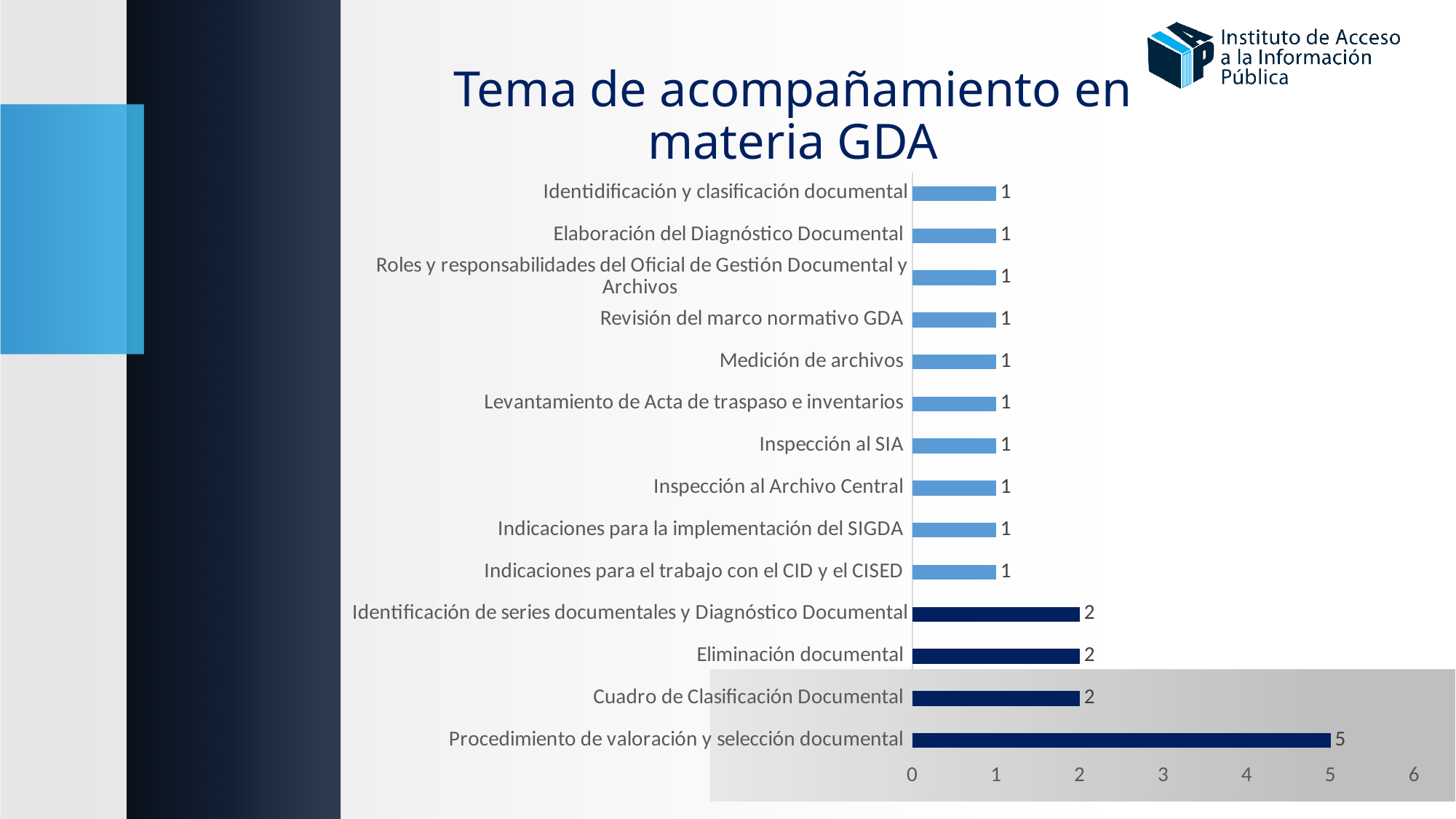
What kind of chart is shown on the slide? Bar chart Which category has the highest value? Procedimiento de valoración y selección documental How many categories are shown in the chart? 14 What is the difference between the values for "Procedimiento de valoración y selección documental" and "Eliminación documental"? 3 How many categories have a value of 2? 3 Which is larger: the value for "Identificación de series documentales y Diagnóstico Documental" or the value for "Medición de archivos"? Identificación de series documentales y Diagnóstico Documental What value is shown for "Inspección al SIA"? 1 Is the value for "Procedimiento de valoración y selección documental" greater or less than 4? greater What value is shown for "Procedimiento de valoración y selección documental"? 5 What is the title of the chart? Tema de acompañamiento en materia GDA What value is shown for "Eliminación documental"? 2 What value is shown for "Cuadro de Clasificación Documental"? 2